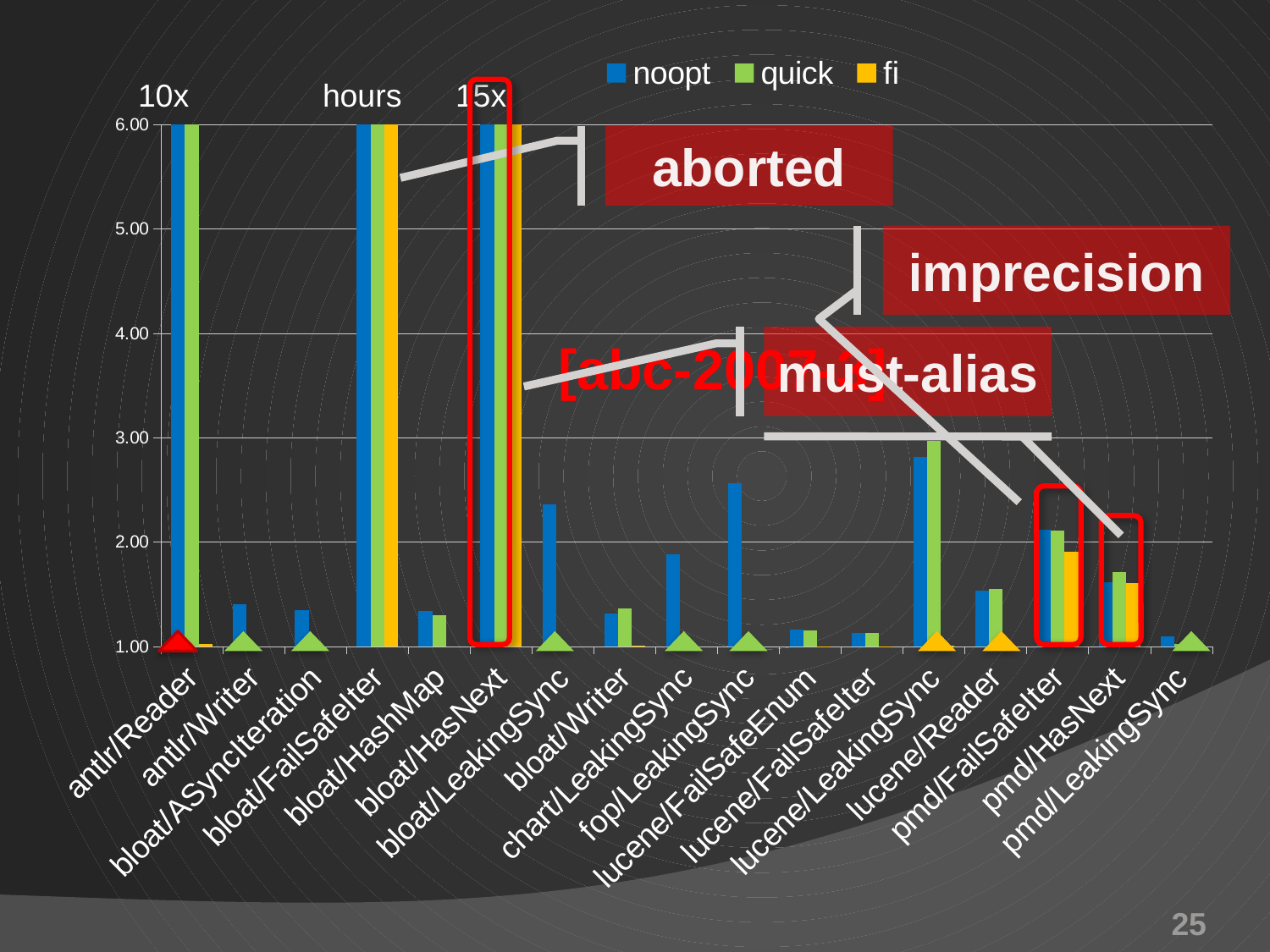
How many series does the legend list? 3 Is the noopt value for lucene/LeakingSync greater or less than 3.00? less Which colour represents the noopt series? blue What are the series names listed in the legend? noopt, quick, fi Is the noopt value for bloat/LeakingSync greater or less than 2.00? greater How many categories are shown along the x axis? 17 Is the noopt value for chart/LeakingSync greater or less than 2.00? less What kind of chart is shown on the slide? bar chart Which is larger, the noopt value for lucene/LeakingSync or the noopt value for lucene/Reader? lucene/LeakingSync Which is larger, the noopt value for fop/LeakingSync or the noopt value for bloat/LeakingSync? fop/LeakingSync